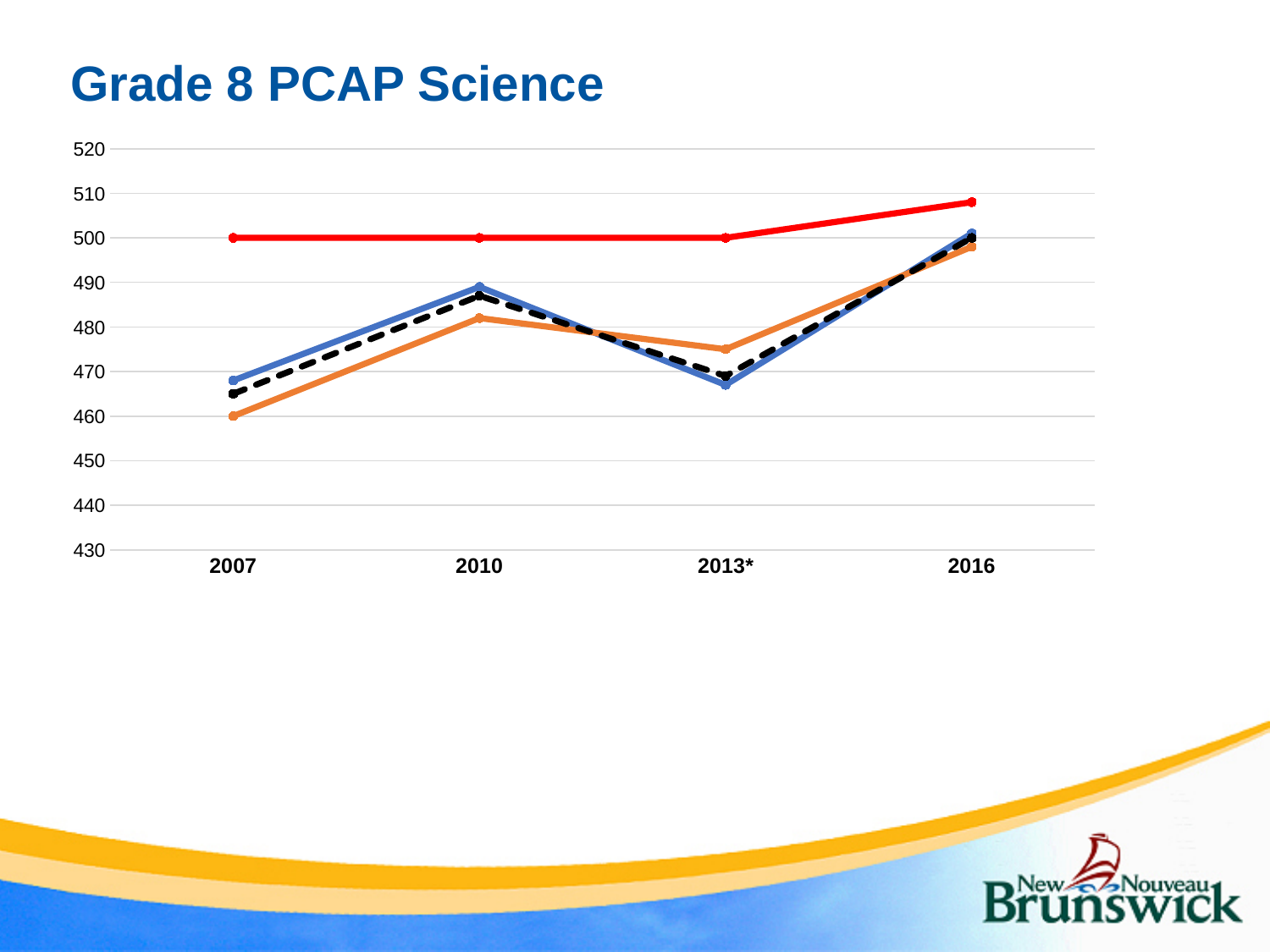
In which year is the orange line at its lowest? 2007 What is the title of the chart? Grade 8 PCAP Science Is the value of the orange line in 2010 greater or less than 490? less What is the value of the orange line in 2007? 460 What kind of chart is shown on the slide? line chart How many lines are plotted on the chart? 4 What is the value of the red line in 2013*? 500 Does the blue line rise or fall from 2010 to 2013*? fall How many years are shown along the x axis? 4 What is the value of the red line in 2007? 500 Is the value of the red line in 2016 greater or less than 500? greater In 2007, which is higher, the blue line or the orange line? blue line